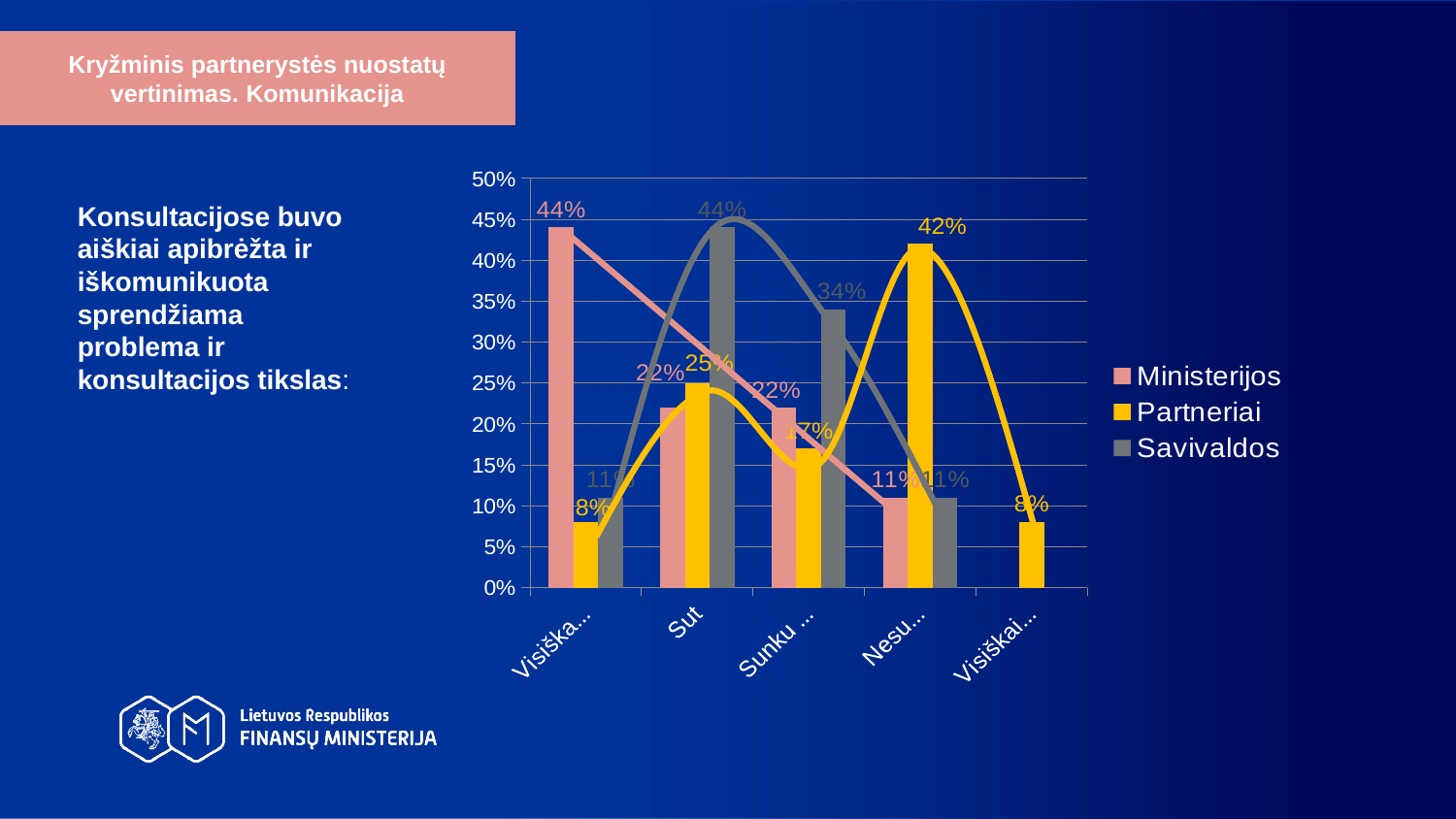
What is the value for Savivaldos in the "Sut" category? 44% In the "Sut" category, what is the difference between the Savivaldos value and the Ministerijos value? 22 percentage points What is the highest value shown for the Partneriai series? 42% How many series does the legend list? 3 What is the value for Partneriai in the "Sut" category? 25% Which colour represents the Partneriai series in the legend? yellow What is the value for Partneriai in the first category? 8% How many categories are shown on the x axis? 5 What kind of chart is shown on the slide? bar chart Which series has the highest value in the "Sut" category? Savivaldos What is the value for Ministerijos in the first category? 44% In the "Sut" category, which is larger: Ministerijos or Partneriai? Partneriai